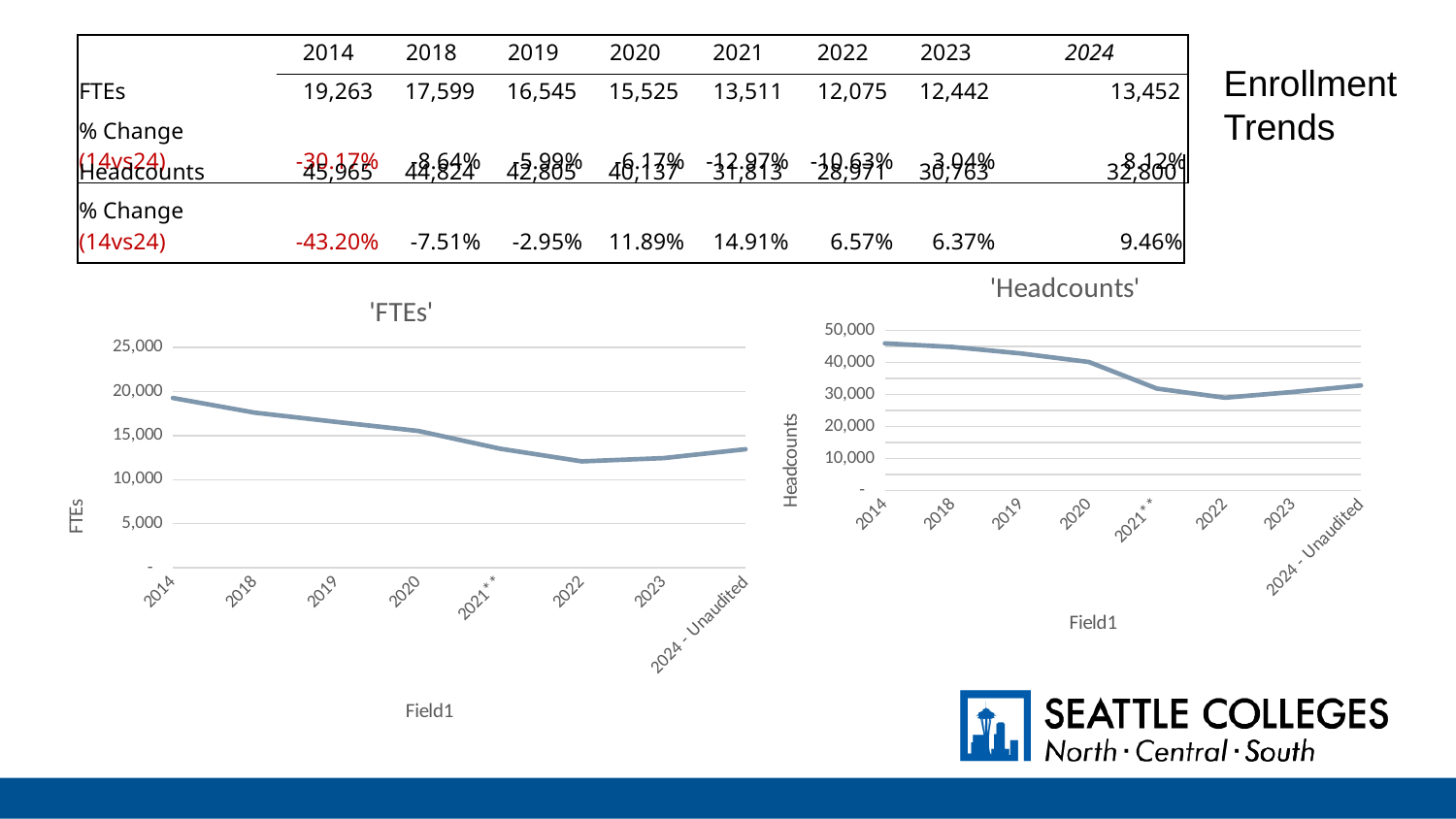
On the 'FTEs' chart, is the value for 2014 greater or less than 15,000? greater On the 'Headcounts' chart, is the value for 2022 greater or less than 30,000? less How many data points are plotted on the 'FTEs' chart? 8 On the 'FTEs' chart, is the value for 2022 greater or less than 15,000? less On the 'Headcounts' chart, which is larger, the value for 2020 or the value for 2021**? 2020 On the 'FTEs' chart, which year has the highest value? 2014 What is the label on the x axis of the 'Headcounts' chart? Field1 On the 'FTEs' chart, do the values rise or fall from 2014 to 2022? fall According to the table, what is the FTEs value for 2014? 19,263 What kind of chart is the 'FTEs' chart? line chart According to the table, what is the FTEs value for 2022? 12,075